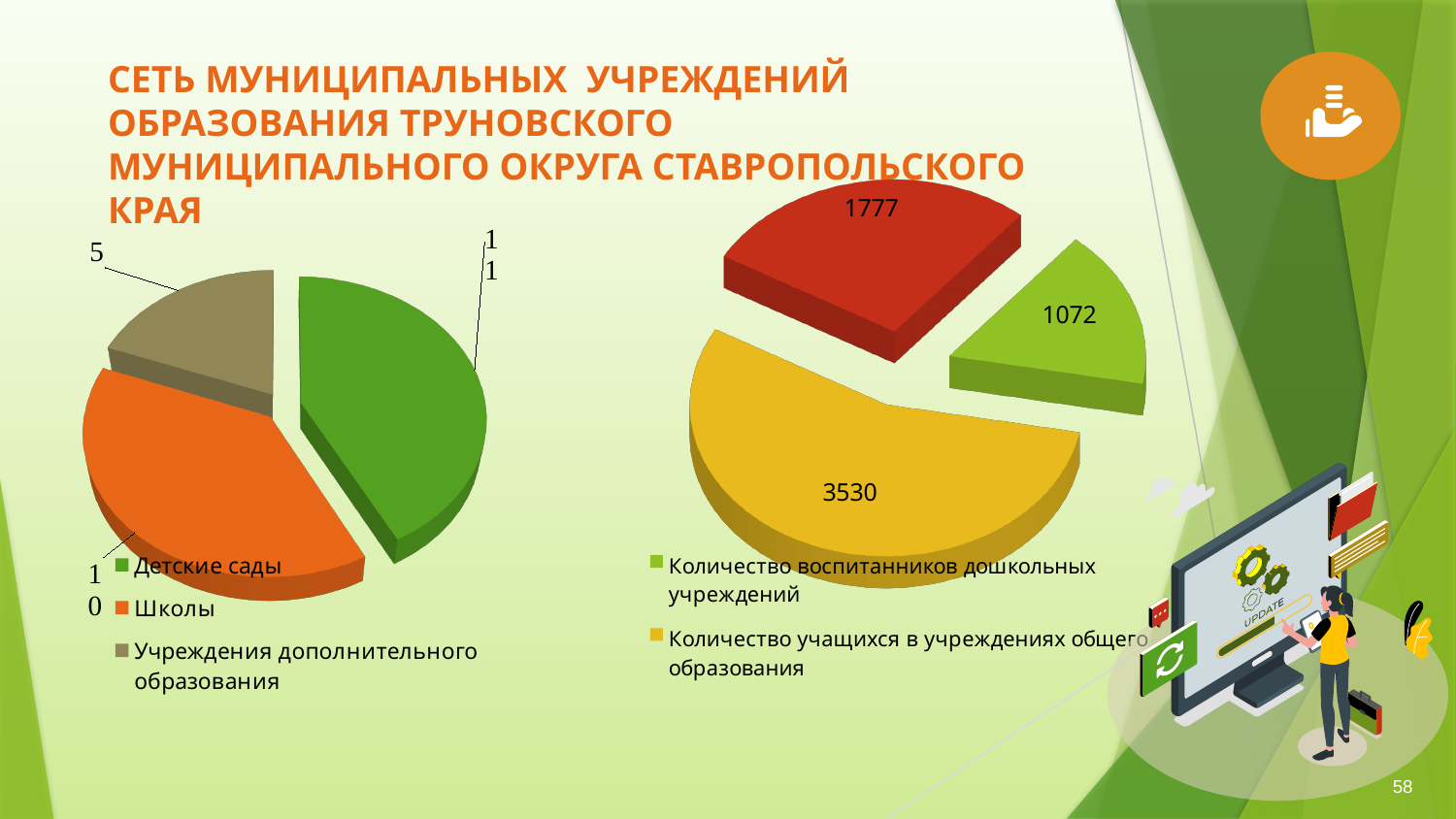
In the right pie chart, what is the difference between the value for Количество учащихся в учреждениях общего образования and the value for Количество воспитанников дошкольных учреждений? 2458 In the right pie chart, how many entries does the legend list? 2 In the left pie chart, which category has the smallest slice? Учреждения дополнительного образования In the right pie chart, what is the value for Количество воспитанников дошкольных учреждений? 1072 In the left pie chart, what is the value for Учреждения дополнительного образования? 5 In the right pie chart, which legend category has the largest slice? Количество учащихся в учреждениях общего образования In the left pie chart, what colour is the slice for Школы? orange In the left pie chart, how many categories does the legend list? 3 What kind of chart is the left chart on the slide? pie chart In the right pie chart, what is the value for Количество учащихся в учреждениях общего образования? 3530 How many slices does the right pie chart have? 3 What kind of chart is the right chart on the slide? pie chart